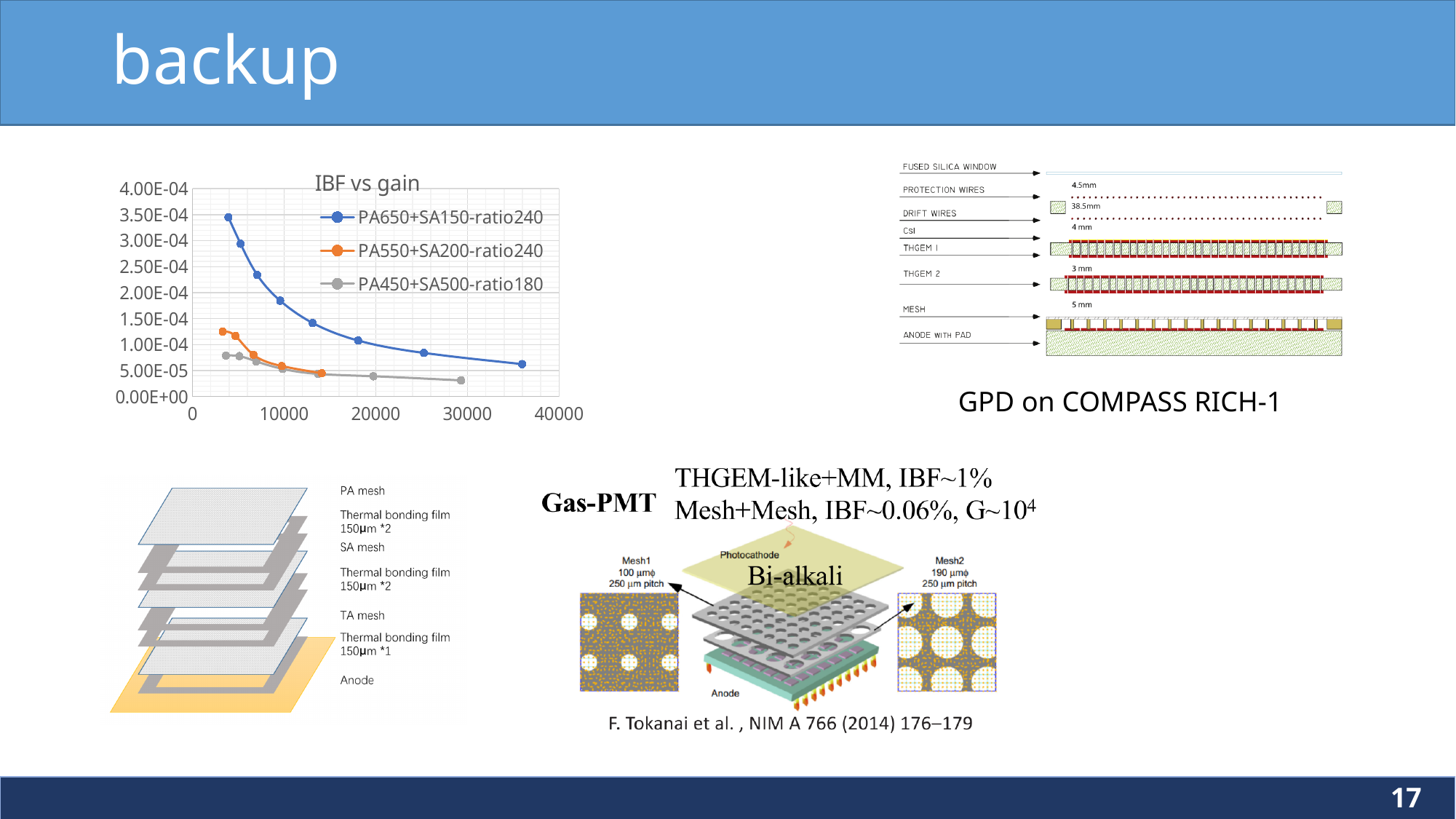
In the 'IBF vs gain' chart, which series is plotted in blue? PA650+SA150-ratio240 In the 'IBF vs gain' chart, at a gain of about 10000, which series has the larger IBF: PA650+SA150-ratio240 or PA550+SA200-ratio240? PA650+SA150-ratio240 In the 'IBF vs gain' chart, is the last (rightmost) value of the PA450+SA500-ratio180 series greater or less than 5.00E-05? less What is the title of the chart on the slide? IBF vs gain In the 'IBF vs gain' chart, which series has the lowest IBF values overall? PA450+SA500-ratio180 In the 'IBF vs gain' chart, is the first (leftmost) value of the PA550+SA200-ratio240 series greater or less than 1.00E-04? greater In the 'IBF vs gain' chart, does the IBF rise or fall as gain increases along the x axis? fall In the 'IBF vs gain' chart, is the highest value of the PA650+SA150-ratio240 series greater or less than 3.00E-04? greater In the 'IBF vs gain' chart, which series extends to the highest gain on the x axis? PA650+SA150-ratio240 In the 'IBF vs gain' chart, which series reaches the highest IBF value? PA650+SA150-ratio240 How many series does the legend of the 'IBF vs gain' chart list? 3 What kind of chart is the 'IBF vs gain' chart? line chart